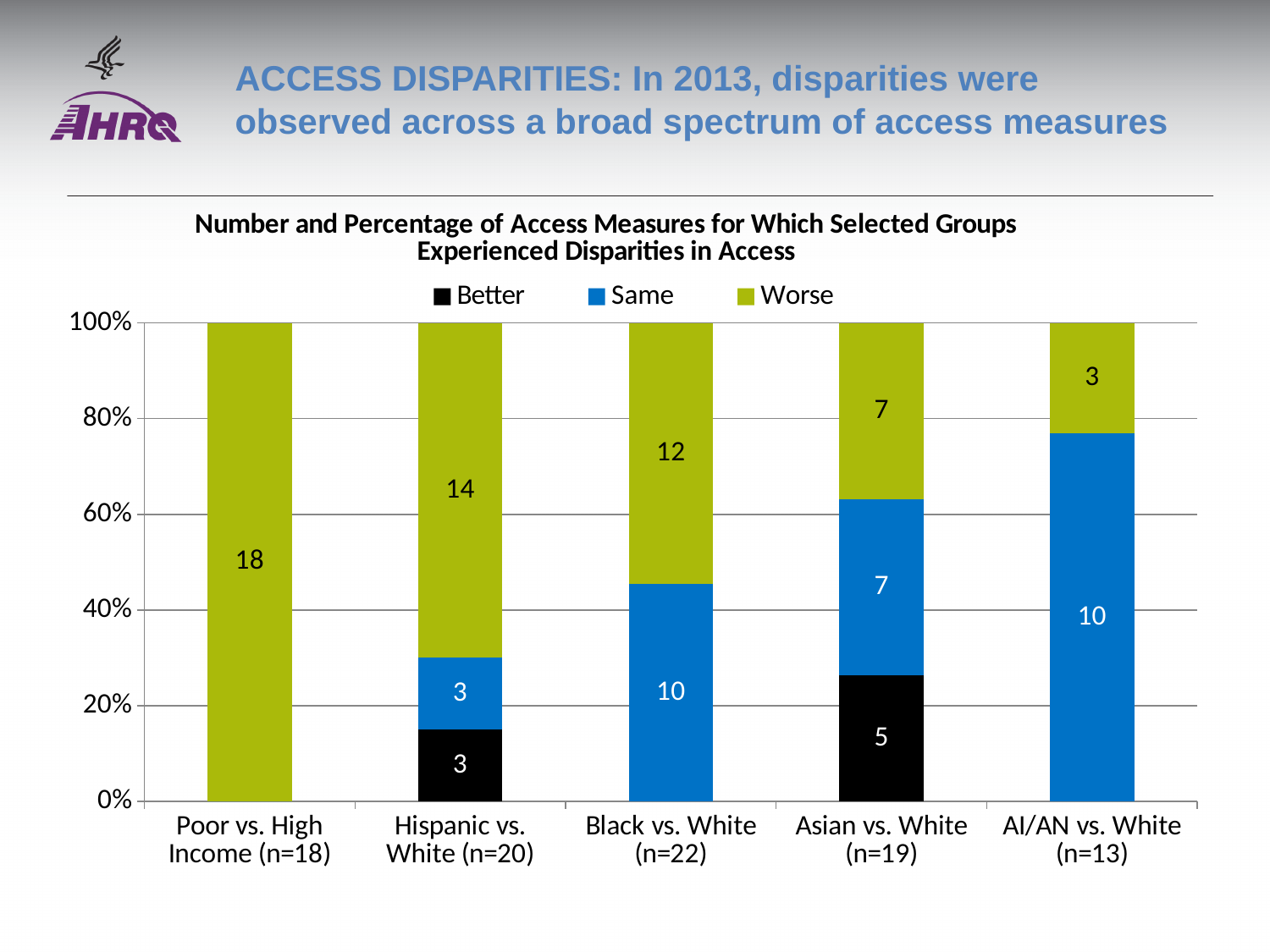
Is the Same value larger for AI/AN vs. White (n=13) or for Hispanic vs. White (n=20)? AI/AN vs. White (n=13) What is the Same value for Black vs. White (n=22)? 10 How many groups (categories) are shown on the x axis? 5 What is the total of the stacked bar for Hispanic vs. White (n=20)? 20 What is the Worse value for Poor vs. High Income (n=18)? 18 What is the Better value for Asian vs. White (n=19)? 5 Which group has the lowest Worse value? AI/AN vs. White (n=13) What type of chart is shown on the slide? Stacked bar chart How many series does the legend list? 3 Which group has the highest Worse value? Poor vs. High Income (n=18) What is the Worse value for Hispanic vs. White (n=20)? 14 What is the difference between the Worse value for Black vs. White (n=22) and the Worse value for AI/AN vs. White (n=13)? 9